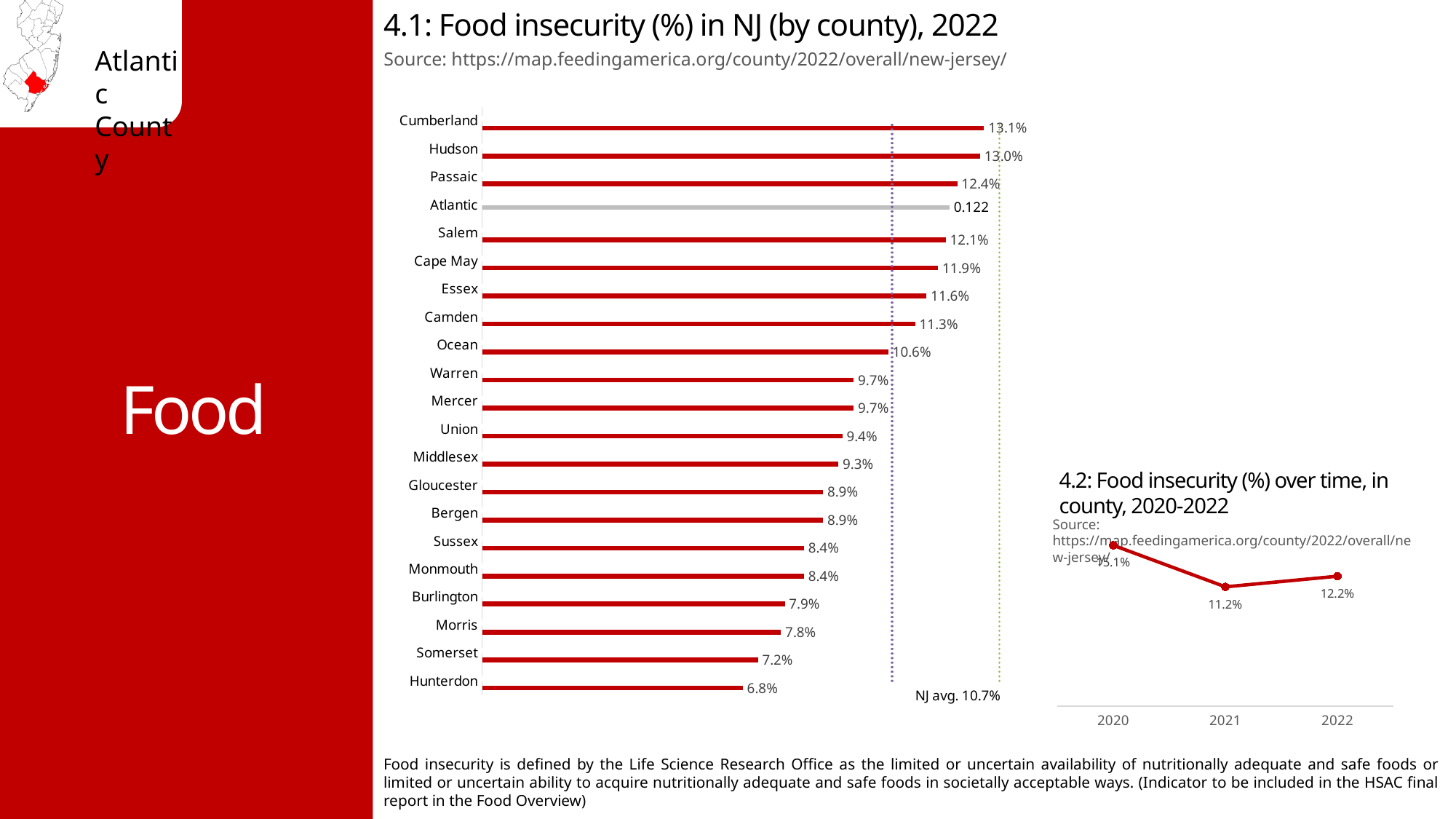
In chart 4.1, what value is labelled on the Atlantic bar? 0.122 In chart 4.2, did the value rise or fall from 2021 to 2022? Rise In chart 4.1, which county has the lowest food insecurity percentage? Hunterdon In chart 4.1, what NJ average value is labelled next to the dotted reference line? 10.7% In chart 4.1, which county has a higher value, Essex or Camden? Essex In chart 4.1, what is the difference between the values for Cumberland and Hunterdon? 6.3% In chart 4.1, what is the food insecurity value for Hunterdon? 6.8% In chart 4.2, what is the food insecurity value for 2021? 11.2% In chart 4.1, how many counties are shown? 21 In chart 4.1, what is the food insecurity value for Cumberland? 13.1% In chart 4.1, which county has the highest food insecurity percentage? Cumberland What kind of chart is chart 4.1? Bar chart